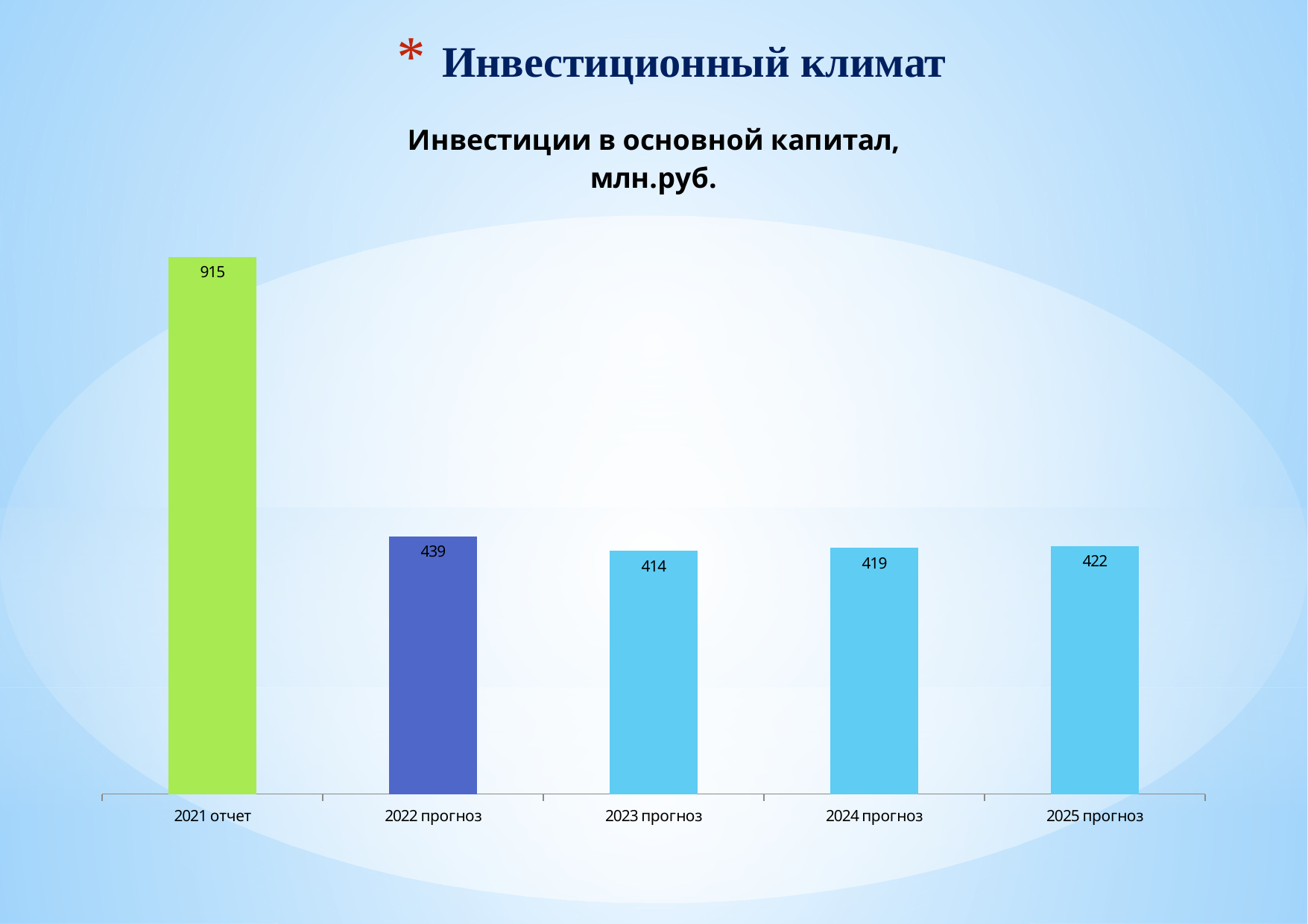
What is the value for 2022 прогноз? 439 What is the difference between the values for 2025 прогноз and 2024 прогноз? 3 How many categories are shown on the x axis? 5 Which category has the lowest value? 2023 прогноз Which is larger, the value for 2022 прогноз or the value for 2024 прогноз? 2022 прогноз What is the value for 2025 прогноз? 422 Which category has the highest value? 2021 отчет What kind of chart is shown on the slide? bar chart What is the title of the chart? Инвестиции в основной капитал, млн.руб. What is the difference between the values for 2021 отчет and 2022 прогноз? 476 What is the value for 2023 прогноз? 414 What is the value for 2021 отчет? 915